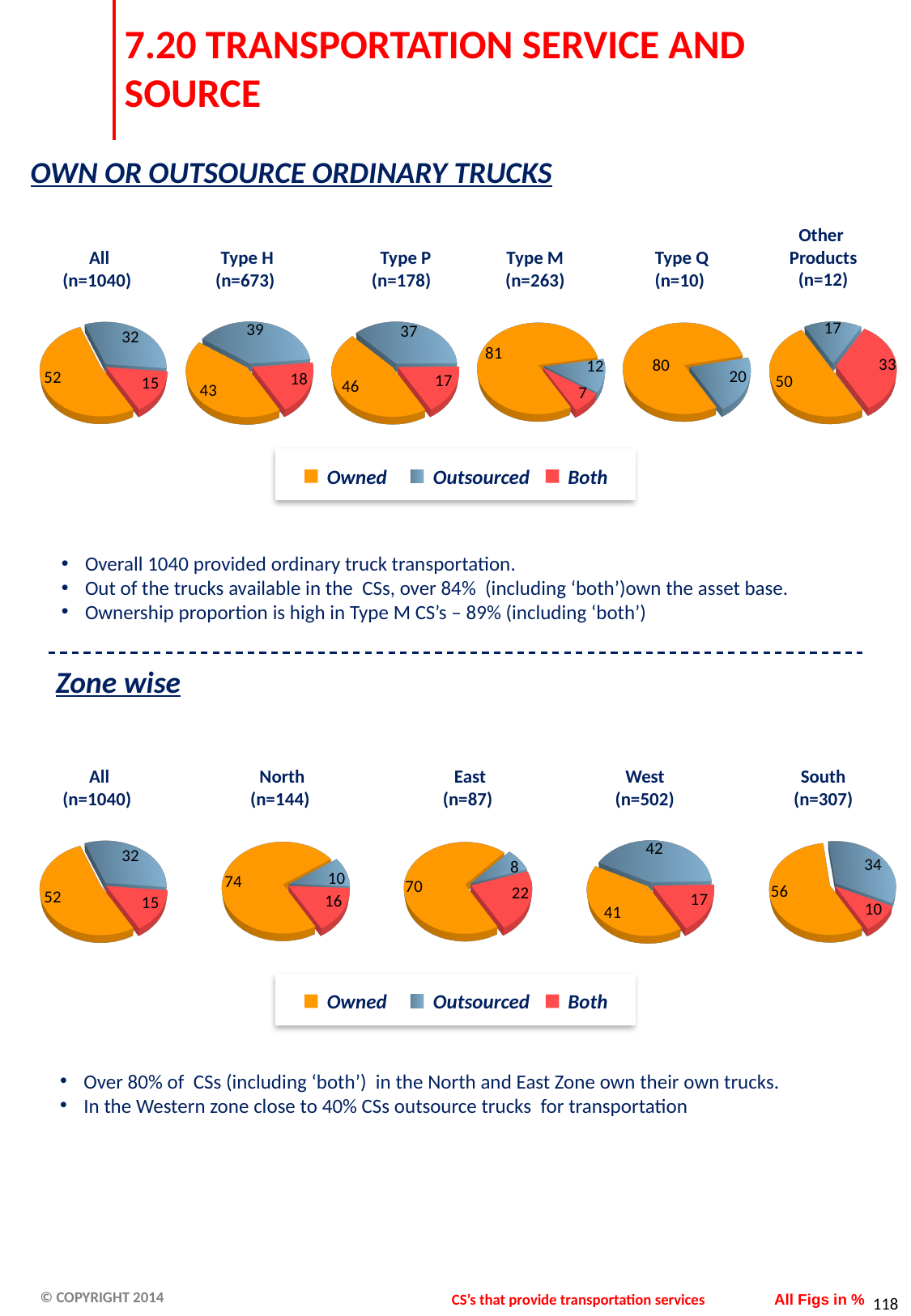
In the Zone wise South (n=307) pie chart, which category has the largest slice? Owned In the Zone wise West (n=502) pie chart, what is the value for Both? 17 In the Type P (n=178) pie chart, what is the difference between the Owned and Outsourced values? 9 How many series does the legend below the Zone wise pie charts list? 3 In the Zone wise section, what is the Owned value in the North (n=144) pie chart? 74 In the Zone wise East (n=87) pie chart, which is larger, Outsourced or Both? Both What type of chart is used to show the Zone wise data? Pie chart In the Type Q (n=10) pie chart, how many slices are shown? 2 In the Type M (n=263) pie chart, what is the value for Outsourced? 12 In the Type H (n=673) pie chart, which category has the smallest slice? Both In the 'Own or outsource ordinary trucks' section, what is the Owned value in the All (n=1040) pie chart? 52 In the Other Products (n=12) pie chart, what is the value for Both? 33